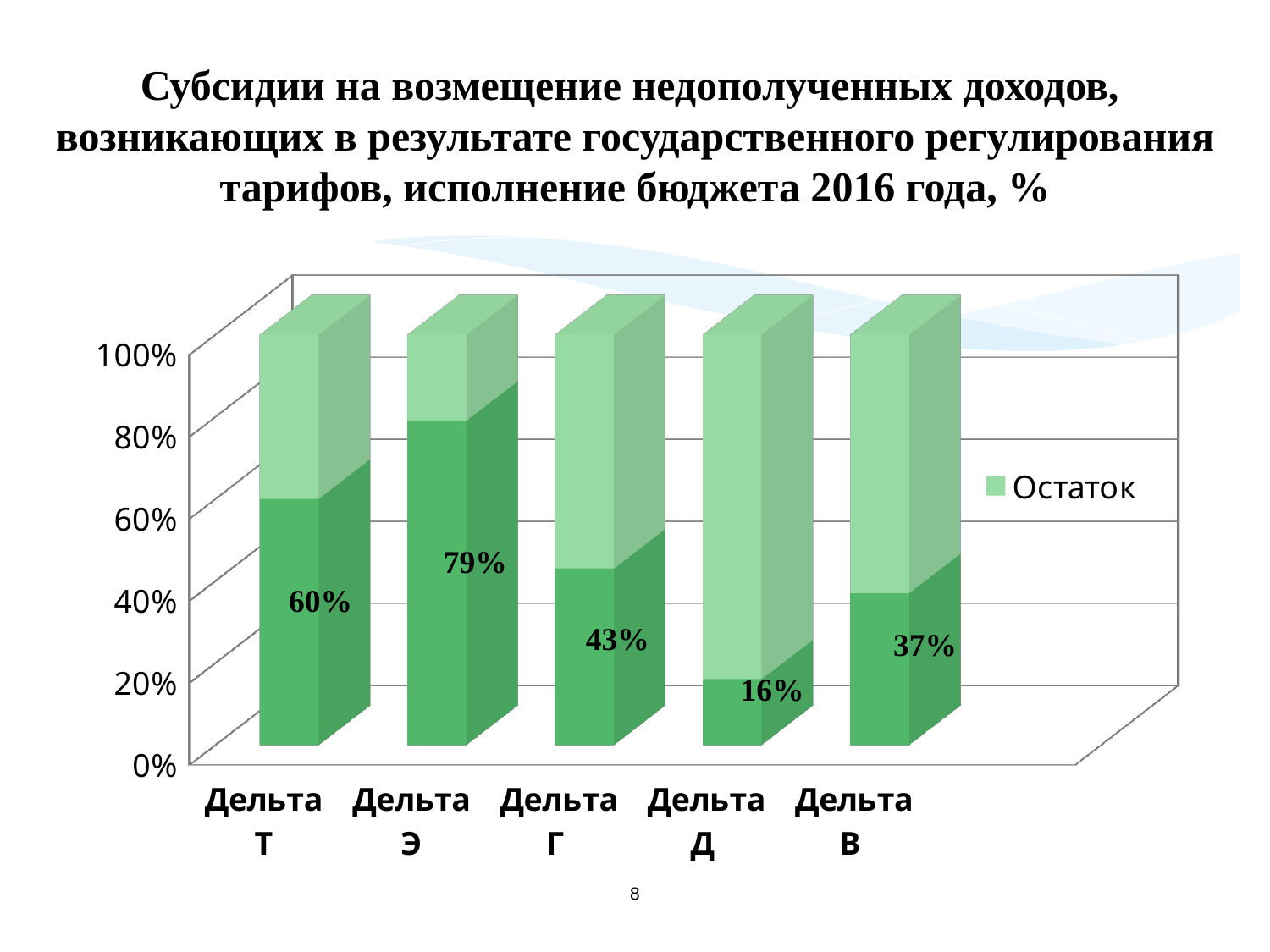
What is the labelled value for Дельта В? 37% Which category has the lowest labelled value? Дельта Д What is the labelled value for Дельта Э? 79% Which has the larger labelled value, Дельта Т or Дельта В? Дельта Т What is the difference between the labelled values for Дельта Э and Дельта Г? 36% Is the labelled value for Дельта Г greater or less than 60%? less What kind of chart is shown on the slide? bar chart What is the labelled value for Дельта Д? 16% Which category has the highest labelled value? Дельта Э What is the labelled value for Дельта Т? 60% How many categories are shown on the x axis? 5 What is the only series name listed in the legend? Остаток